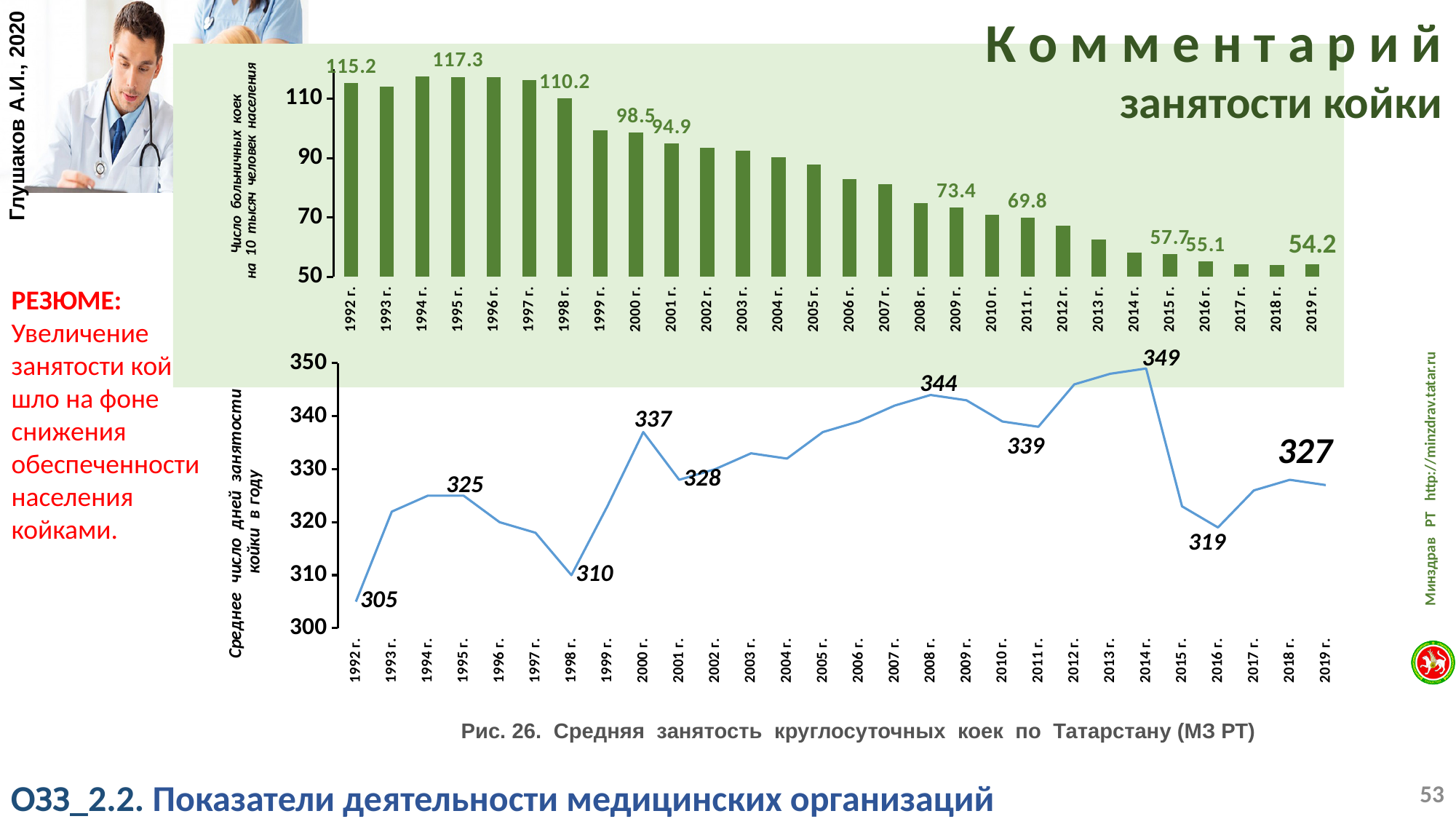
In the bottom line chart, which year has the highest value? 2014 In the bottom line chart, which is larger: the value for 2000 or the value for 2001? 2000 In the top bar chart, by how much did the value fall from 1992 (115.2) to 2019 (54.2)? 61 In the top bar chart, do the values generally rise or fall from 1992 to 2019? fall In the top bar chart, what is the value for 1998? 110.2 In the top bar chart, what is the number of hospital beds per 10 thousand population in 1992? 115.2 What kind of chart is the top chart on the slide? bar chart In the bottom line chart, what is the value for 1992? 305 In the bottom line chart, what is the difference between the 2014 value (349) and the 2016 value (319)? 30 In the top bar chart, what is the value for 2019? 54.2 In the top bar chart, is the value for 2006 greater or less than 90? less In the bottom line chart, what is the average bed occupancy (days per year) in 2014? 349